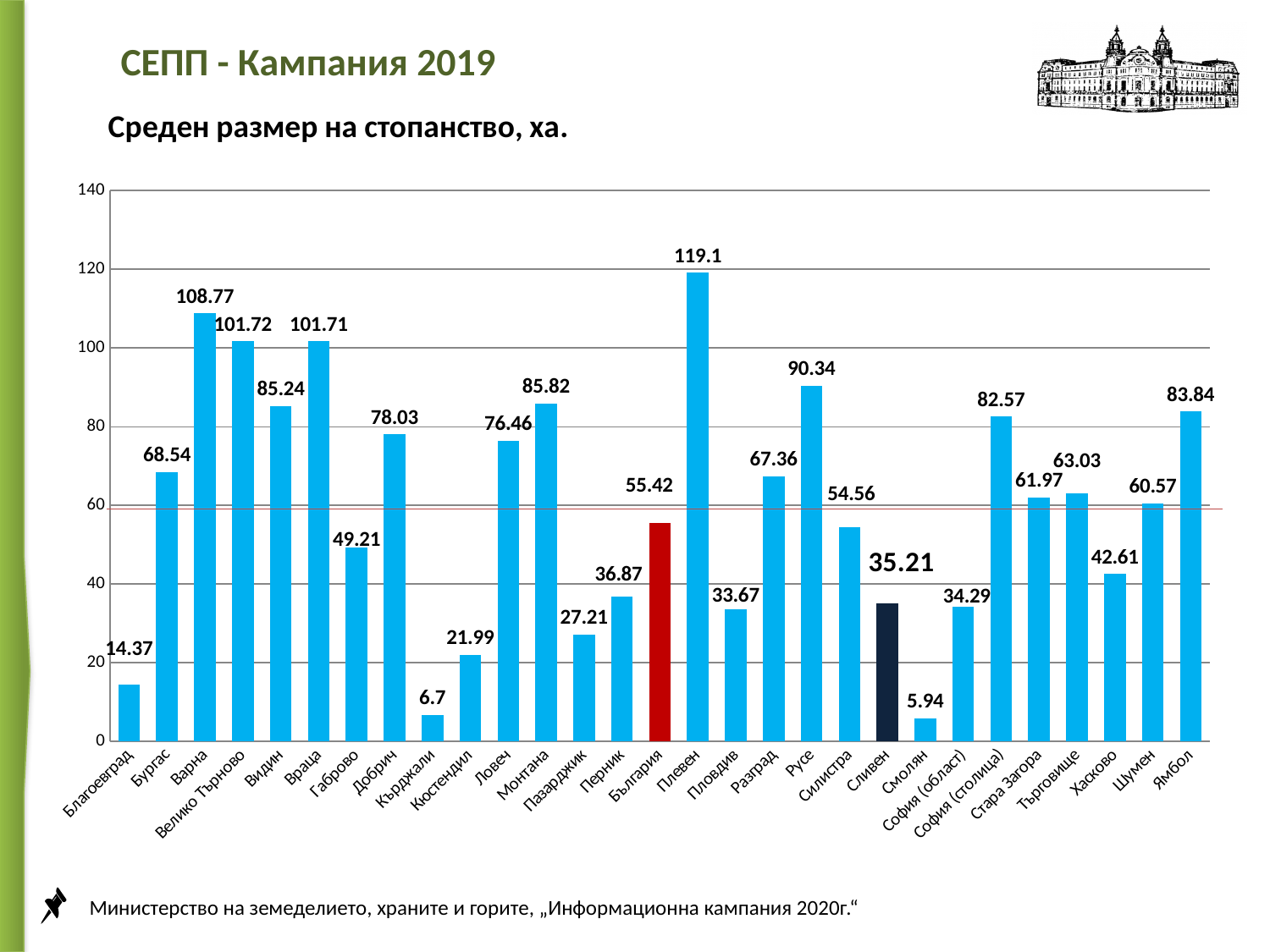
What is the value for Сливен? 35.21 What kind of chart is shown on the slide? bar chart Which category has the lowest value? Смолян What is the difference between the values for Варна and Бургас? 40.23 Which is larger, the value for Русе or the value for Добрич? Русе What is the value for Кърджали? 6.7 Which category has the highest value? Плевен What is the difference between the values for Плевен and България? 63.68 What is the value for Плевен? 119.1 How many categories are shown on the x axis? 29 What is the value for България? 55.42 Is the value for Ямбол greater or less than 80? greater